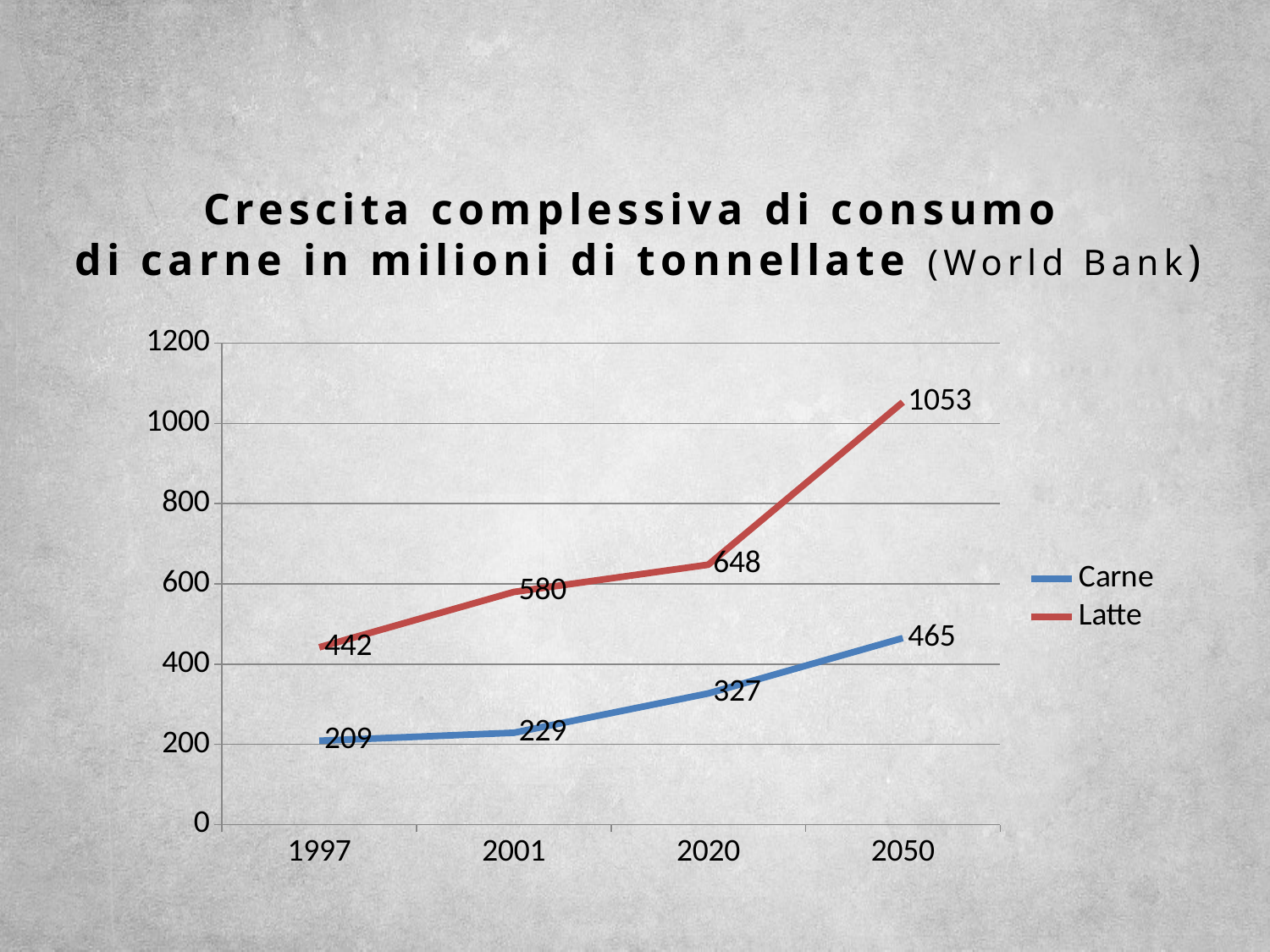
What is the value for Latte in 2020? 648 Do the Carne values rise or fall from 1997 to 2050? Rise How many series does the legend list? 2 What kind of chart is shown on the slide? Line chart What is the difference between the Latte and Carne values in 2050? 588 In which year is the Carne value lowest? 1997 What is the value for Carne in 2001? 229 In which year is the Latte value highest? 2050 How many years are shown on the x axis? 4 What is the value for Latte in 2050? 1053 What is the value for Carne in 1997? 209 Which series has the larger value in 2020, Carne or Latte? Latte